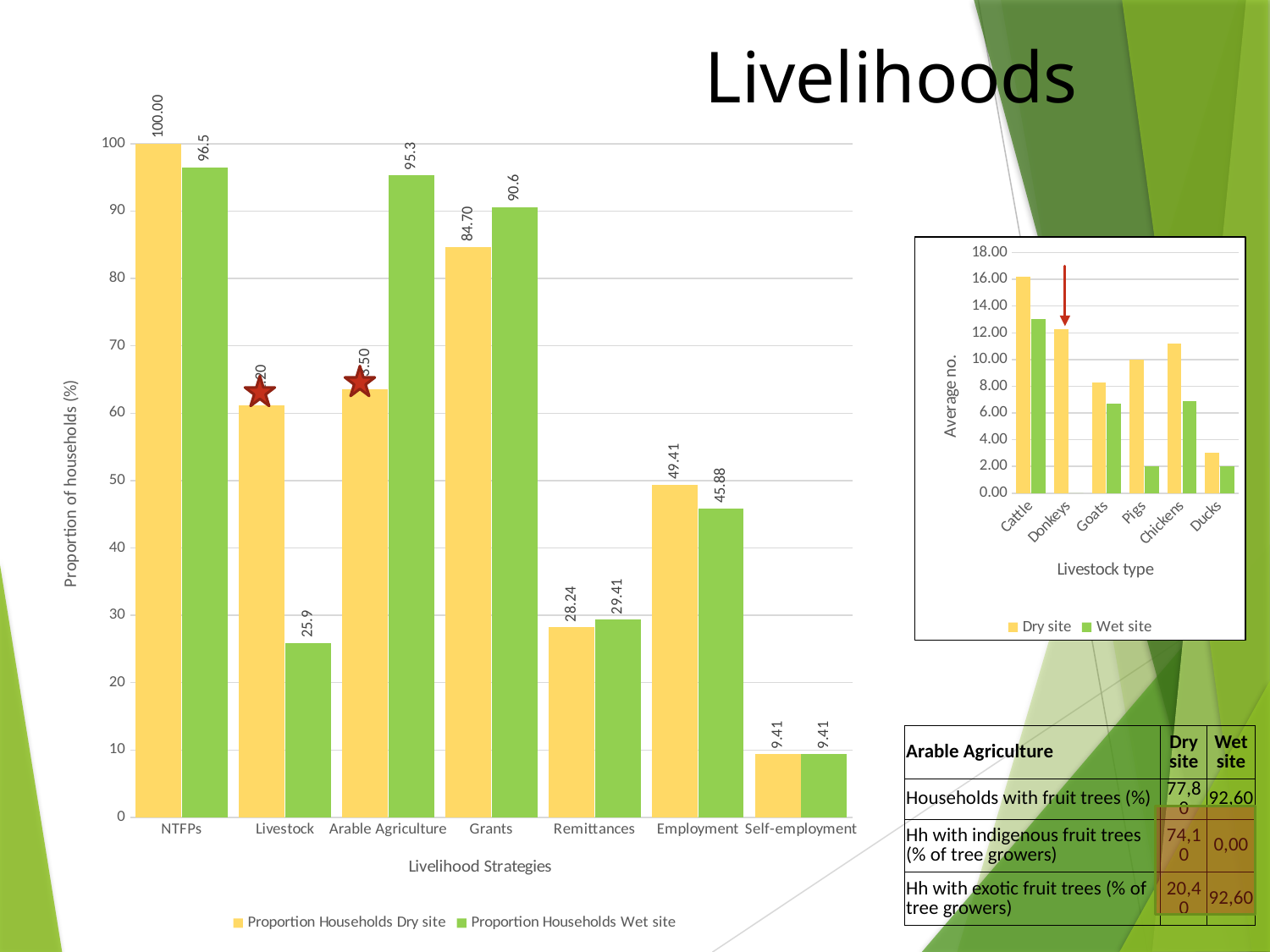
In the Livelihood Strategies chart, which livelihood strategy has the highest Proportion Households Dry site value? NTFPs In the Livestock type chart, is the Wet site average number for Pigs greater or less than 4.00? less In the Livelihood Strategies chart, what is the Proportion Households Dry site value for NTFPs? 100.00 In the Livelihood Strategies chart, which is larger for Remittances: the Dry site value or the Wet site value? Wet site In the Livelihood Strategies chart, which livelihood strategy has the lowest Proportion Households Wet site value? Self-employment In the Livelihood Strategies chart, what is the difference between the Wet site and Dry site values for Grants? 5.9 In the Livestock type chart, is the Dry site average number for Cattle greater or less than 14.00? greater How many series does the legend of the Livestock type chart list? 2 How many livelihood strategies are shown on the x axis of the Livelihood Strategies chart? 7 In the Livelihood Strategies chart, what is the Proportion Households Wet site value for Grants? 90.6 In the Livelihood Strategies chart, what is the Proportion Households Wet site value for Livestock? 25.9 In the Livelihood Strategies chart, what is the Proportion Households Dry site value for Employment? 49.41